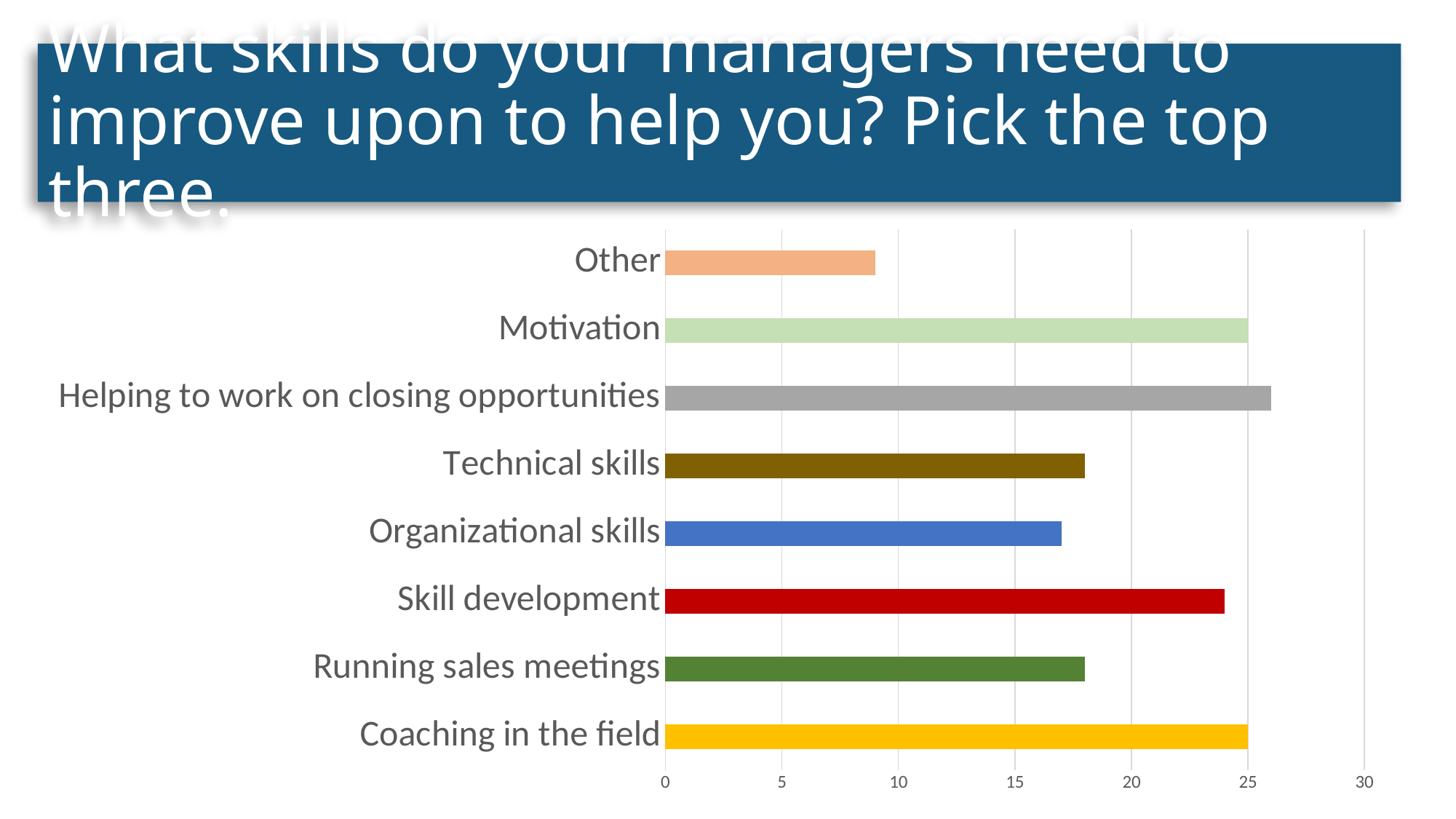
Is the value for Technical skills greater or less than 20? less Is the value for Organizational skills greater or less than 15? greater Is the value for Skill development greater or less than 20? greater How many categories are plotted in the chart? 8 Which is larger, the value for Other or the value for Organizational skills? Organizational skills Which category has the shortest bar? Other What kind of chart is shown on the slide? bar chart Which category has the longest bar? Helping to work on closing opportunities What is the title of the slide containing the chart? What skills do your managers need to improve upon to help you? Pick the top three. Which is larger, the value for Skill development or the value for Technical skills? Skill development